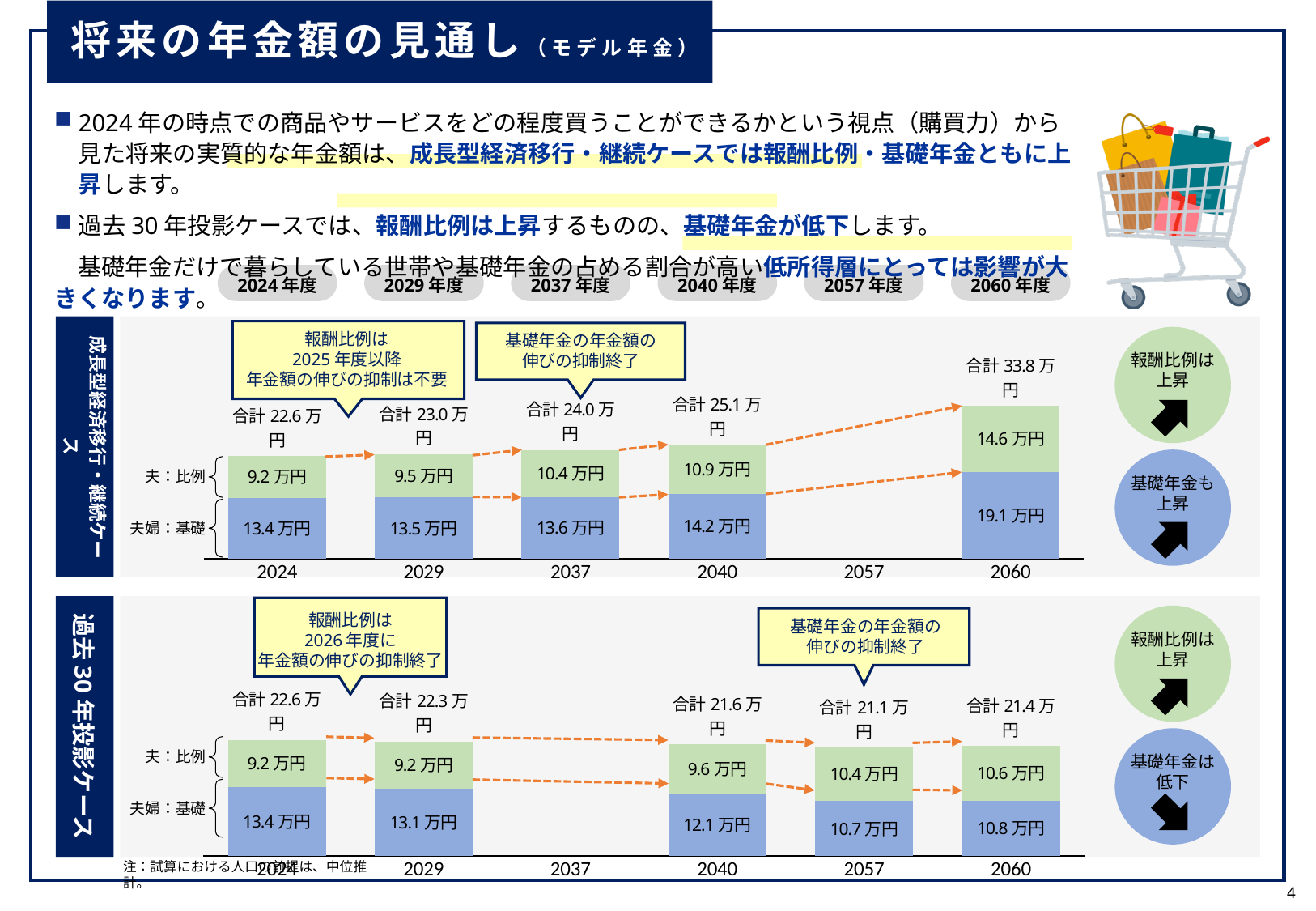
In the 成長型経済移行・継続ケース chart, what is the total (合計) for 2037? 24.0万円 What type of chart is used in the 成長型経済移行・継続ケース section? stacked bar chart In the 過去30年投影ケース chart, what is the 夫婦：基礎 value for 2057? 10.7万円 In the 成長型経済移行・継続ケース chart, which year has the highest 夫婦：基礎 value? 2060 In the 成長型経済移行・継続ケース chart, what is the 夫：比例 value for 2060? 14.6万円 In the 過去30年投影ケース chart, which year has the lowest total (合計)? 2057 In the 過去30年投影ケース chart, what is the 夫：比例 value for 2040? 9.6万円 In the 成長型経済移行・継続ケース chart, how many years have bars plotted? 5 In the 過去30年投影ケース chart, does the 夫婦：基礎 value rise or fall from 2024 to 2057? fall In the 成長型経済移行・継続ケース chart, what is the 夫婦：基礎 value for 2040? 14.2万円 In the 過去30年投影ケース chart, which is larger: the 夫：比例 value for 2060 or the 夫婦：基礎 value for 2060? 夫婦：基礎 (10.8万円) In the 過去30年投影ケース chart, what is the difference between the 夫婦：基礎 values for 2024 and 2060? 2.6万円